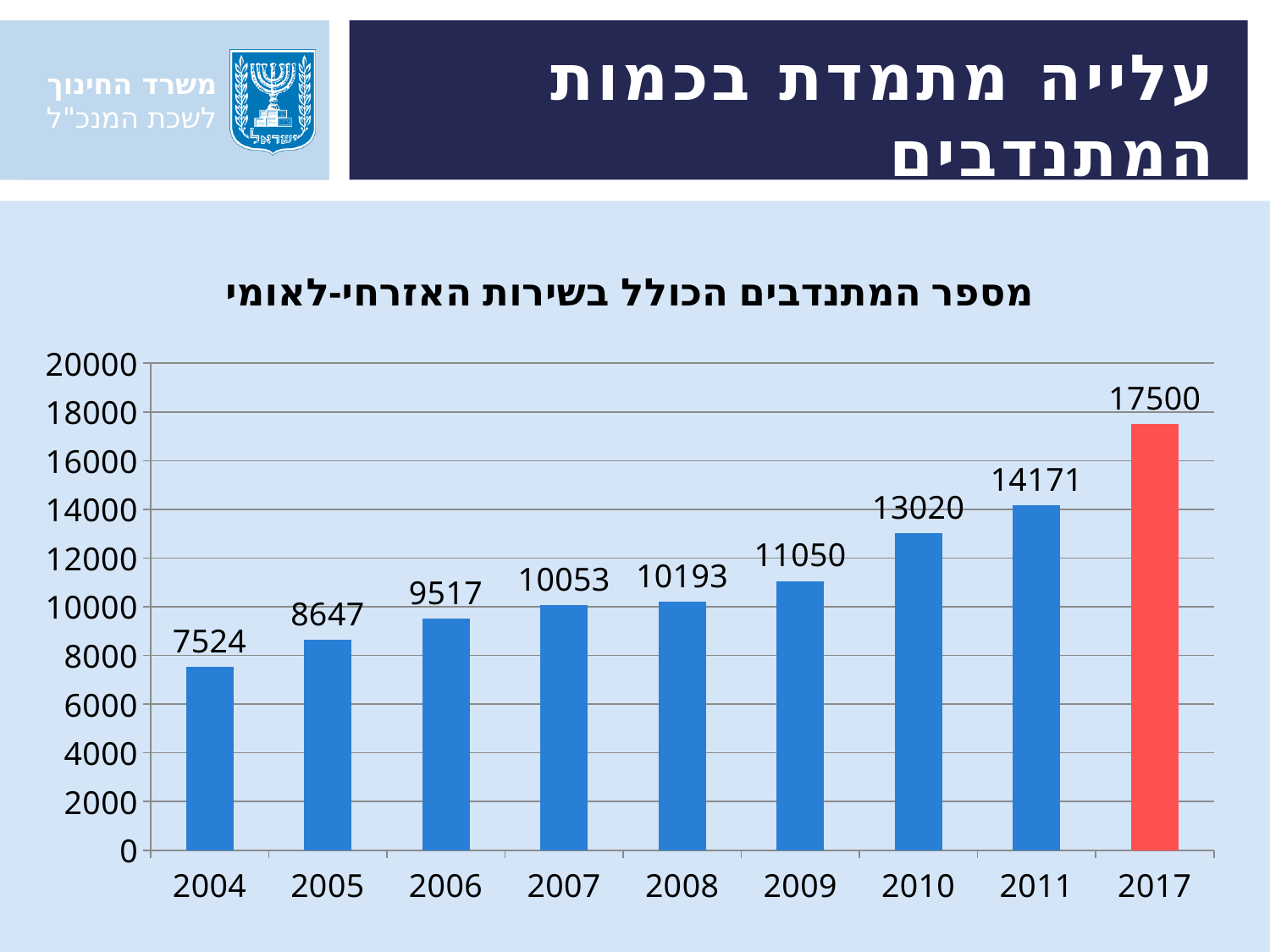
What is the value for 2004? 7524 Do the values rise or fall from 2004 to 2017? rise What is the difference between the values for 2017 and 2004? 9976 Is the value for 2006 greater or less than 10000? less Which is larger, the value for 2009 or the value for 2008? 2009 Which year has the lowest value? 2004 How many years are shown on the x axis? 9 What is the difference between the values for 2011 and 2010? 1151 What is the value for 2017? 17500 Which year has the highest value? 2017 What kind of chart is this? bar chart What is the value for 2010? 13020